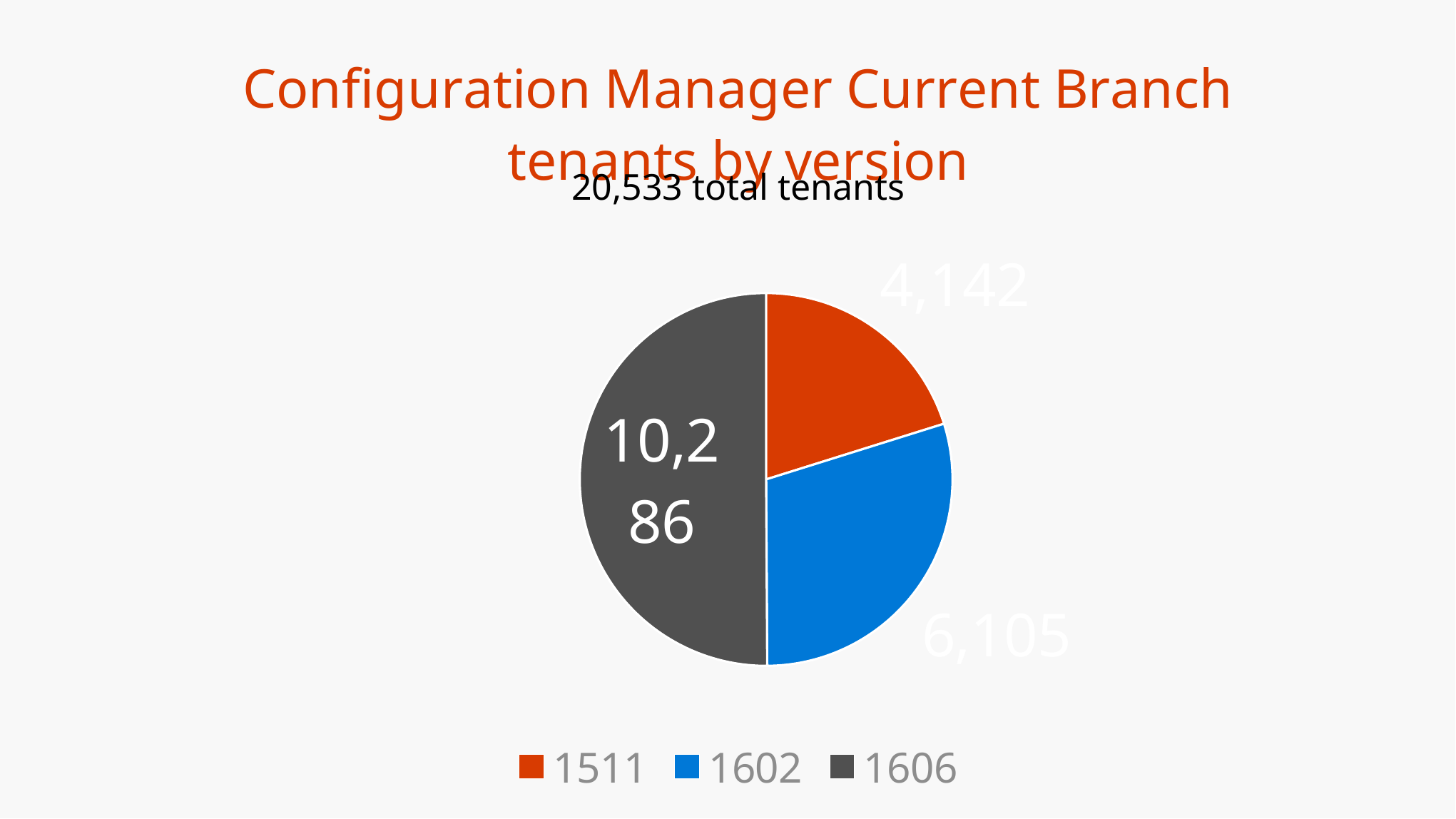
Which has more tenants, version 1511 or version 1602? 1602 What type of chart is shown on the slide? Pie chart How many tenants are on version 1602? 6,105 What is the total number of tenants stated on the slide? 20,533 What is the difference in tenants between version 1602 and version 1511? 1,963 How many versions are shown in the pie chart? 3 Which version has the fewest tenants? 1511 How many more tenants are on version 1606 than on version 1602? 4,181 How many tenants are on version 1606? 10,286 How many tenants are on version 1511? 4,142 Which version has the most tenants? 1606 What colour is the slice for version 1606? Dark grey